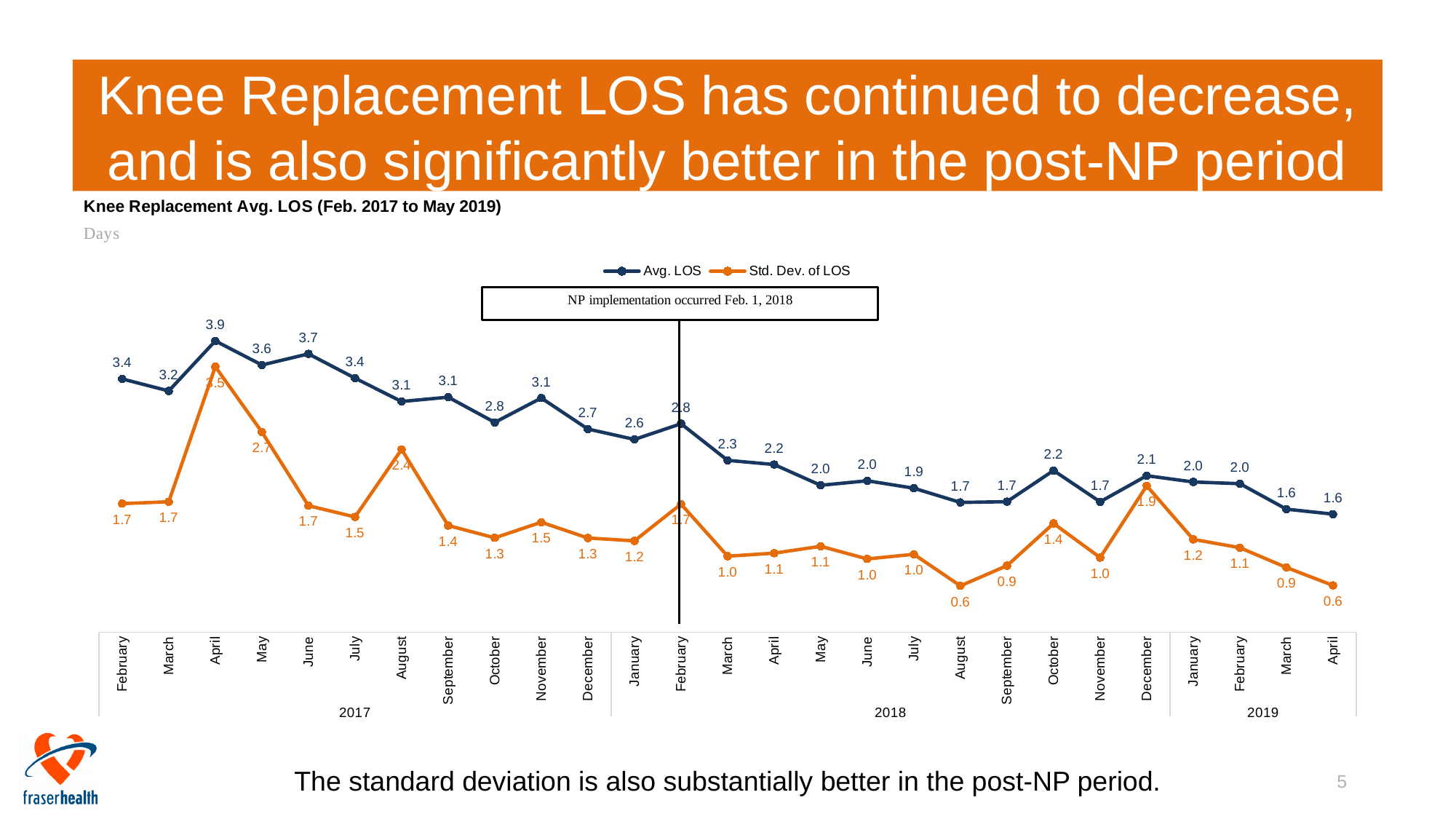
What type of chart is shown on the slide? Line chart What was the Avg. LOS in April 2017? 3.9 What was the Std. Dev. of LOS in December 2018? 1.9 How many months are plotted on the x axis? 27 What was the Std. Dev. of LOS in August 2018? 0.6 Which month had the higher Avg. LOS, October 2018 or November 2018? October 2018 Does the Avg. LOS generally rise or fall from February 2017 to April 2019? Fall How many series does the legend list? 2 What event does the annotation box above the vertical line describe? NP implementation occurred Feb. 1, 2018 What was the Avg. LOS in February 2018? 2.8 In which month was the Avg. LOS highest? April 2017 What is the difference between the Avg. LOS in February 2017 and April 2019? 1.8